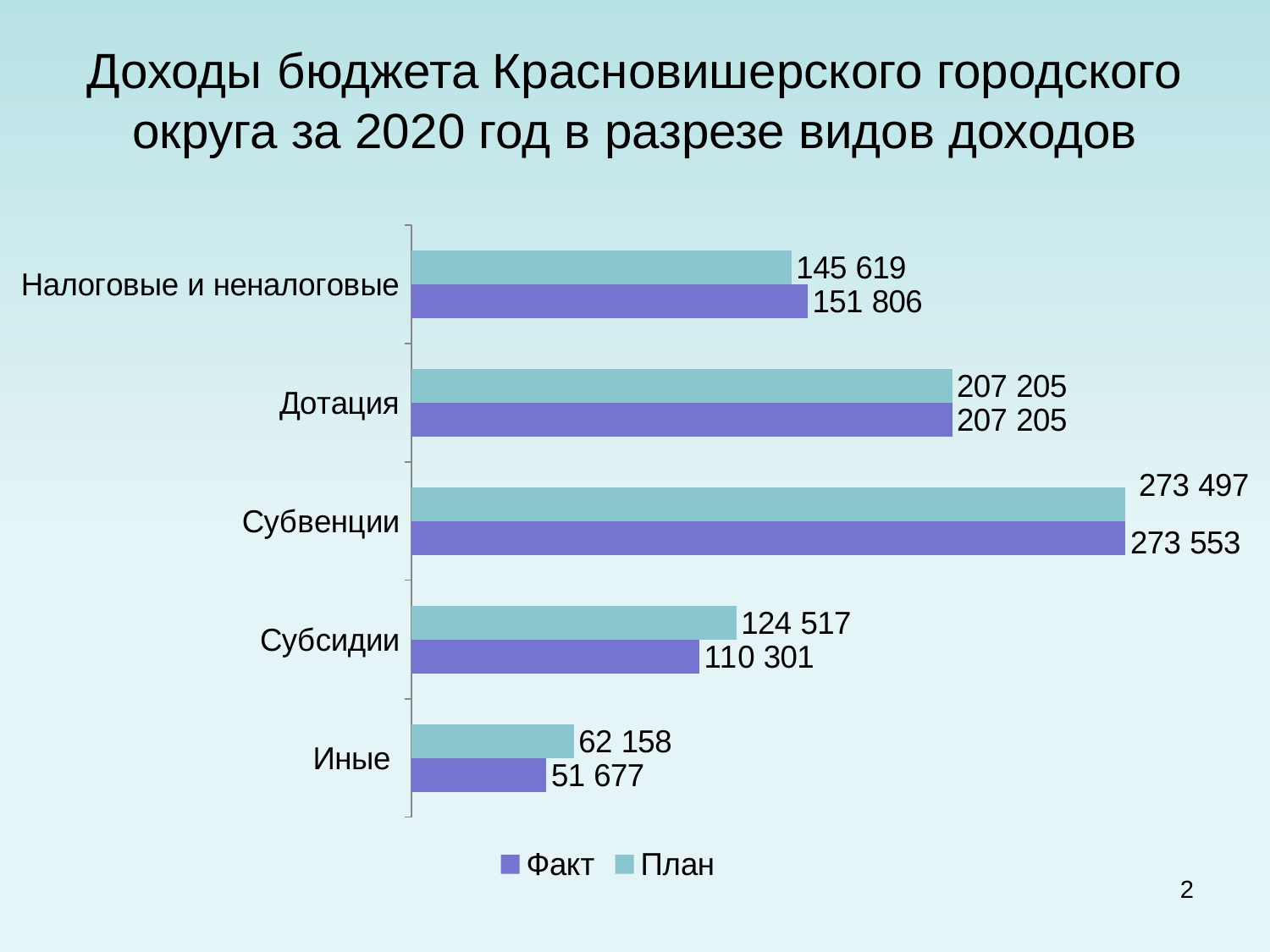
What is the difference between the План and Факт values for Субсидии? 14 216 Which category has the highest Факт value? Субвенции Which category has the lowest План value? Иные What kind of chart is shown on the slide? Bar chart What is the Факт value for Иные? 51 677 How many series does the legend list? 2 What is the План value for Налоговые и неналоговые? 145 619 What is the difference between the План and Факт values for Иные? 10 481 How many categories are shown on the chart? 5 What is the Факт value for Субсидии? 110 301 Which is larger for Субсидии, the Факт value or the План value? План What is the План value for Субвенции? 273 497